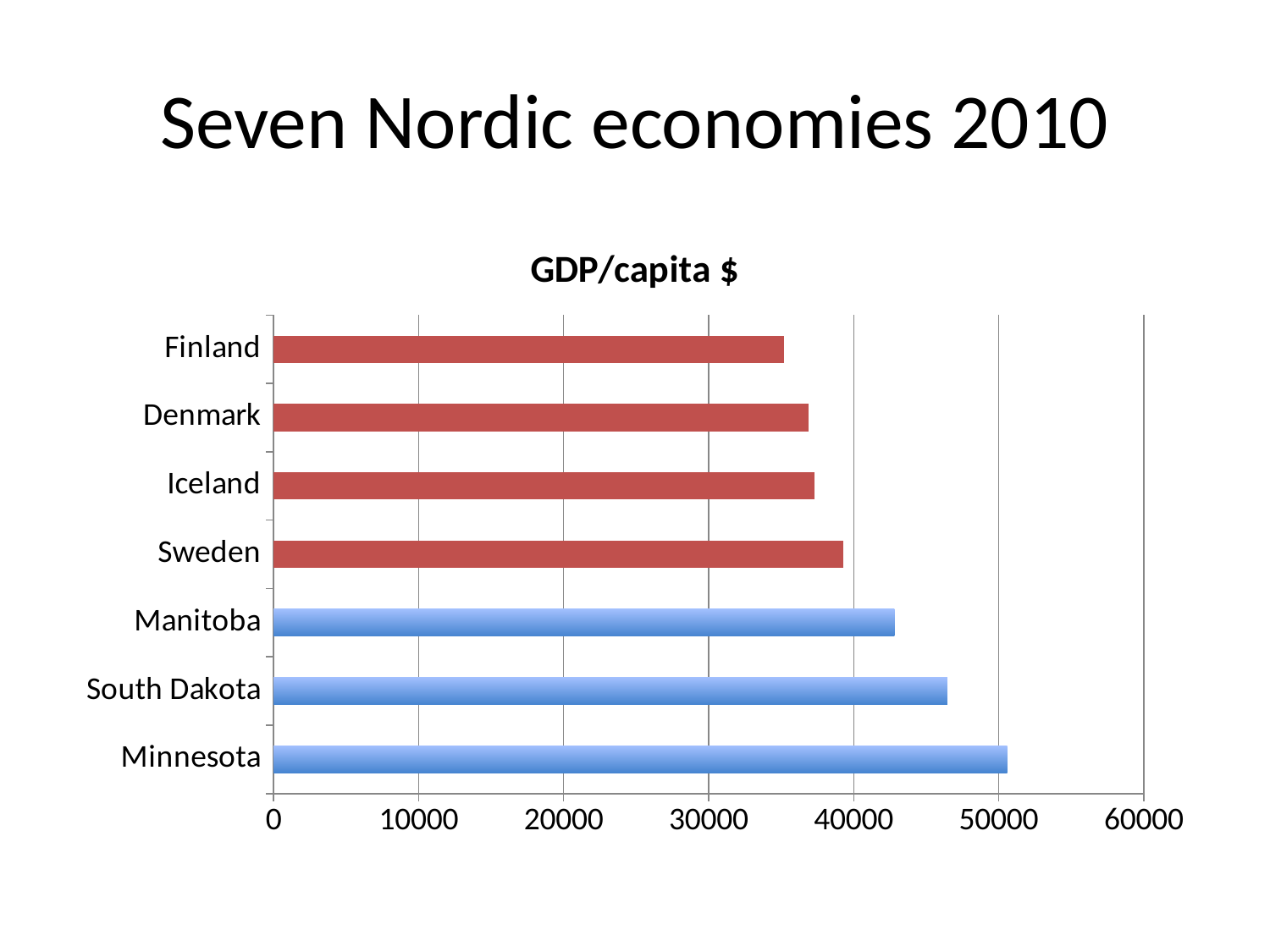
Is the GDP/capita $ value for South Dakota greater or less than 40000? greater Which has a higher GDP/capita $, Manitoba or Sweden? Manitoba What is the title of the chart? GDP/capita $ Is the GDP/capita $ value for Minnesota greater or less than 40000? greater Is the GDP/capita $ value for Denmark greater or less than 40000? less Which category has the lowest GDP/capita $? Finland Which category has the highest GDP/capita $? Minnesota What kind of chart is shown on the slide? bar chart Which has a higher GDP/capita $, South Dakota or Manitoba? South Dakota How many categories are plotted in the GDP/capita $ chart? 7